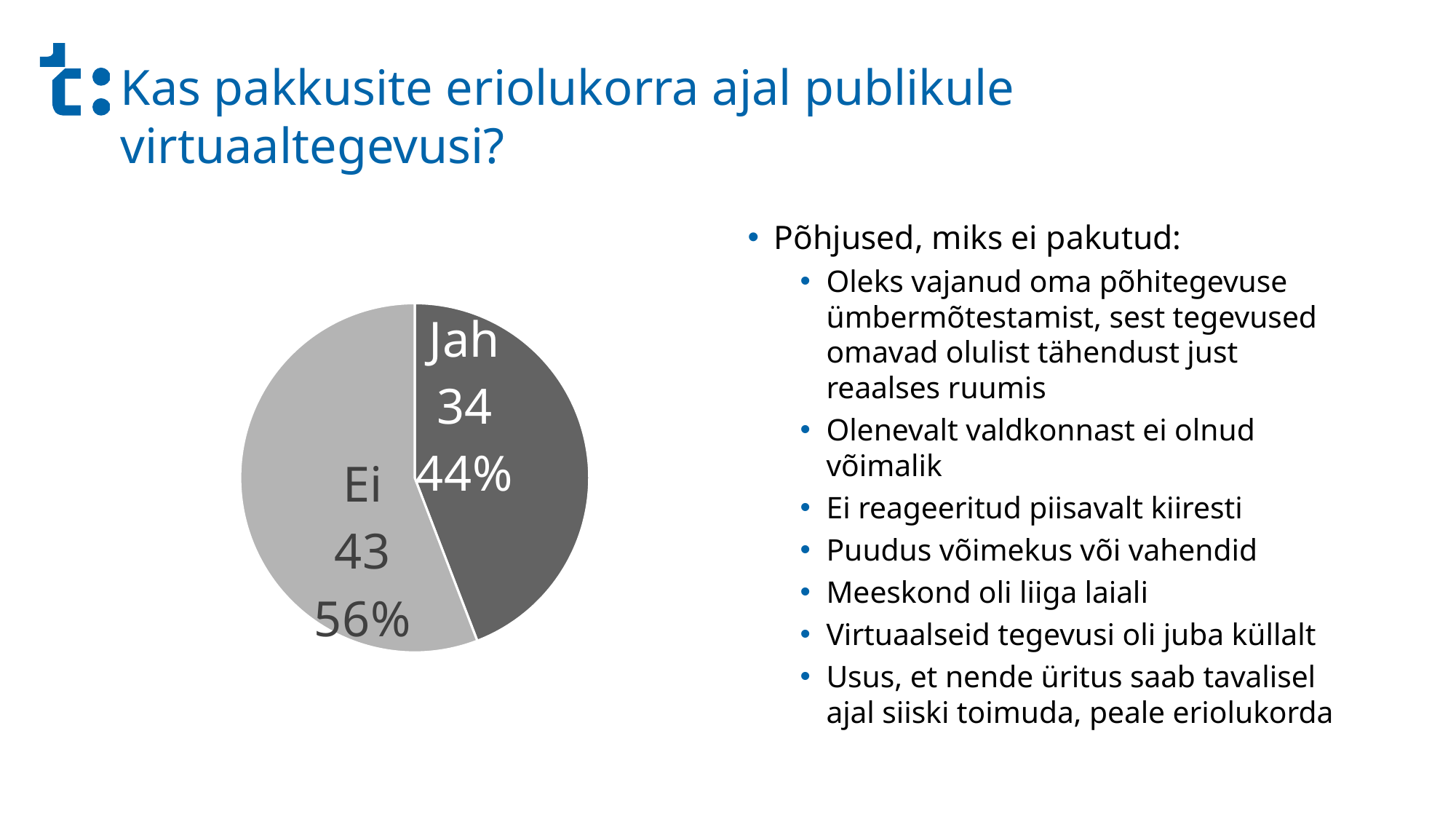
What is the total of the counts shown in the pie chart? 77 What is the difference between the counts for "Ei" and "Jah"? 9 What kind of chart is shown on the slide? pie chart Which slice is the smallest in the pie chart? Jah How many slices does the pie chart have? 2 Which is larger, the count for "Jah" or the count for "Ei"? Ei Which slice of the pie chart is shown in the darker grey colour? Jah What is the count shown for the "Ei" slice? 43 What percentage share does the "Ei" slice have? 56% Which slice is the largest in the pie chart? Ei What is the count shown for the "Jah" slice? 34 What percentage share does the "Jah" slice have? 44%